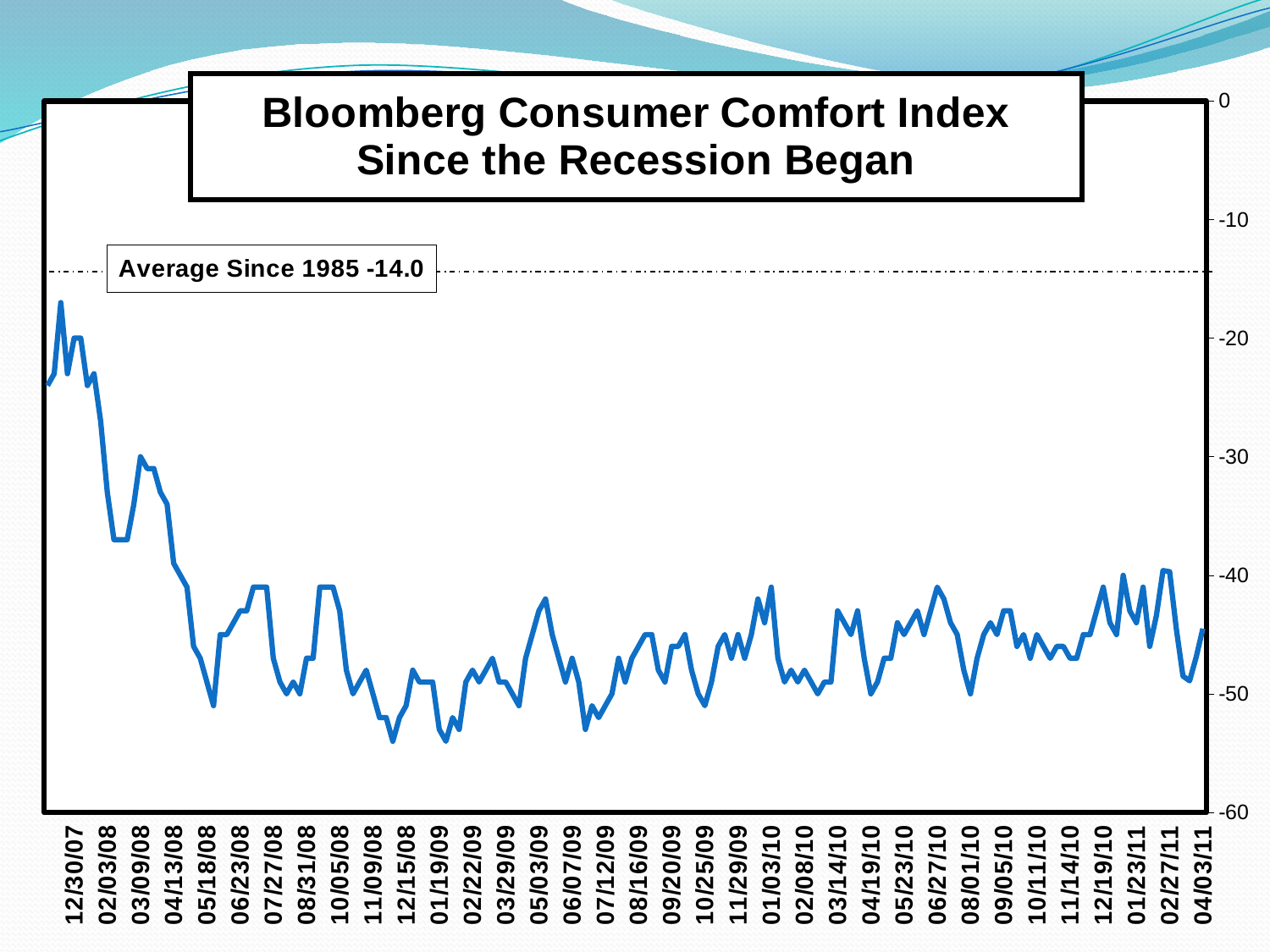
Is the index value at 12/30/07 above or below -30 on the axis? above What value does the dashed horizontal reference line represent, according to its label? Average Since 1985 -14.0 Is the highest point of the line near the beginning or near the end of the period shown? near the beginning Is the index value at 01/19/09 above or below -50 on the axis? below Is the index at the end of the period (04/03/11) higher or lower than at the start (12/30/07)? lower Does the plotted line ever rise above the Average Since 1985 reference line? No Does the index rise or fall between 12/30/07 and 05/18/08? fall What are the lowest and highest values shown on the vertical axis? -60 and 0 What is the title of the chart? Bloomberg Consumer Comfort Index Since the Recession Began Is the index value at 04/03/11 above or below -40 on the axis? below What kind of chart is shown on the slide? line chart